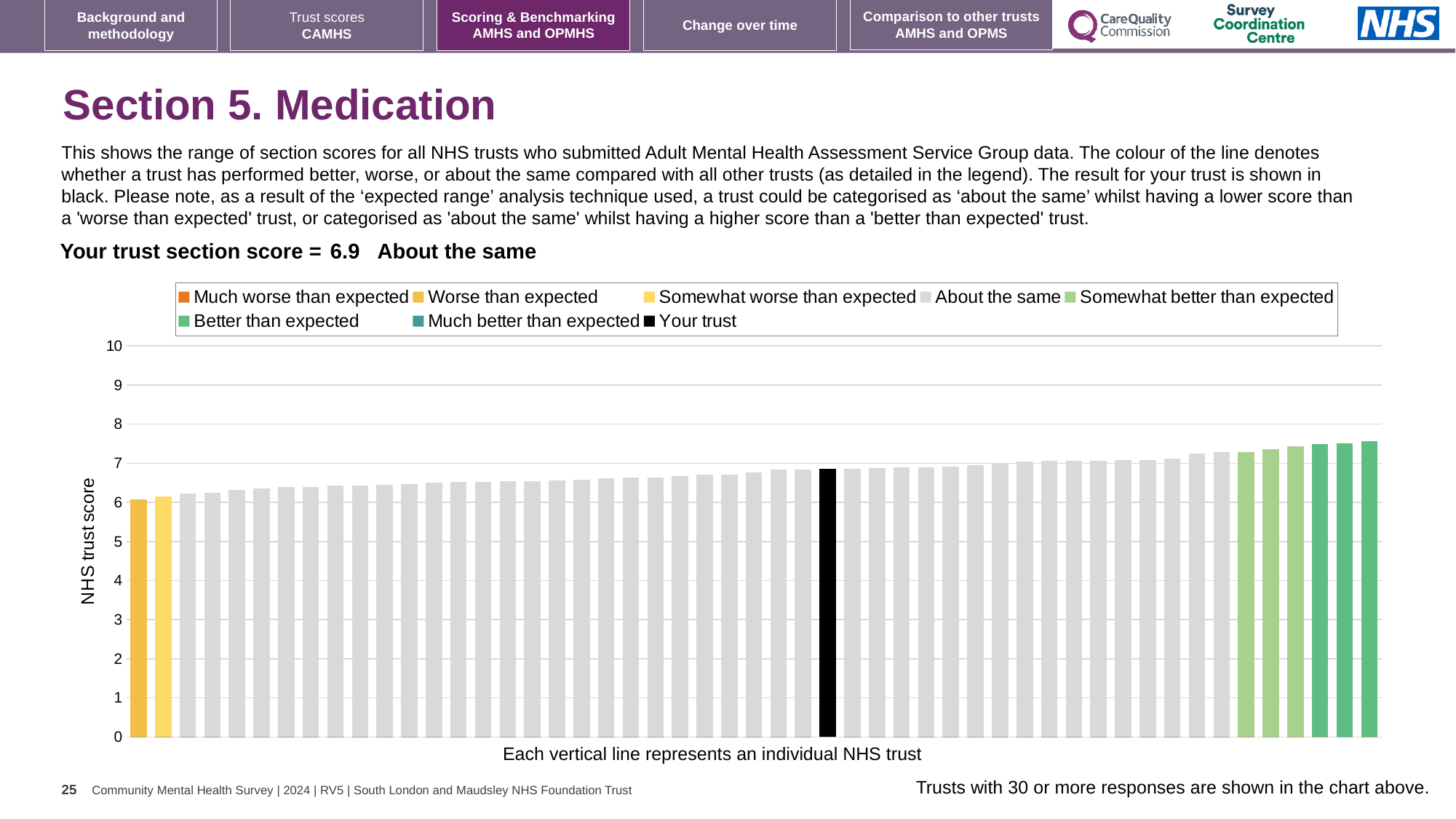
Is the value of the shortest bar greater or less than 5? greater Do the bar values rise or fall from left to right along the x axis? rise Is the value of the tallest bar greater or less than 8? less What is the section score for your trust shown on the slide? 6.9 Which legend category does the tallest bar belong to? Better than expected What kind of chart is shown on the slide? bar chart Is the value of the black 'Your trust' bar greater or less than 5? greater What colour is the bar representing your trust? black Which legend category does the shortest bar belong to? Worse than expected How many bars are coloured as 'Worse than expected'? 1 What is the title of the vertical axis? NHS trust score How many entries does the chart legend list? 8